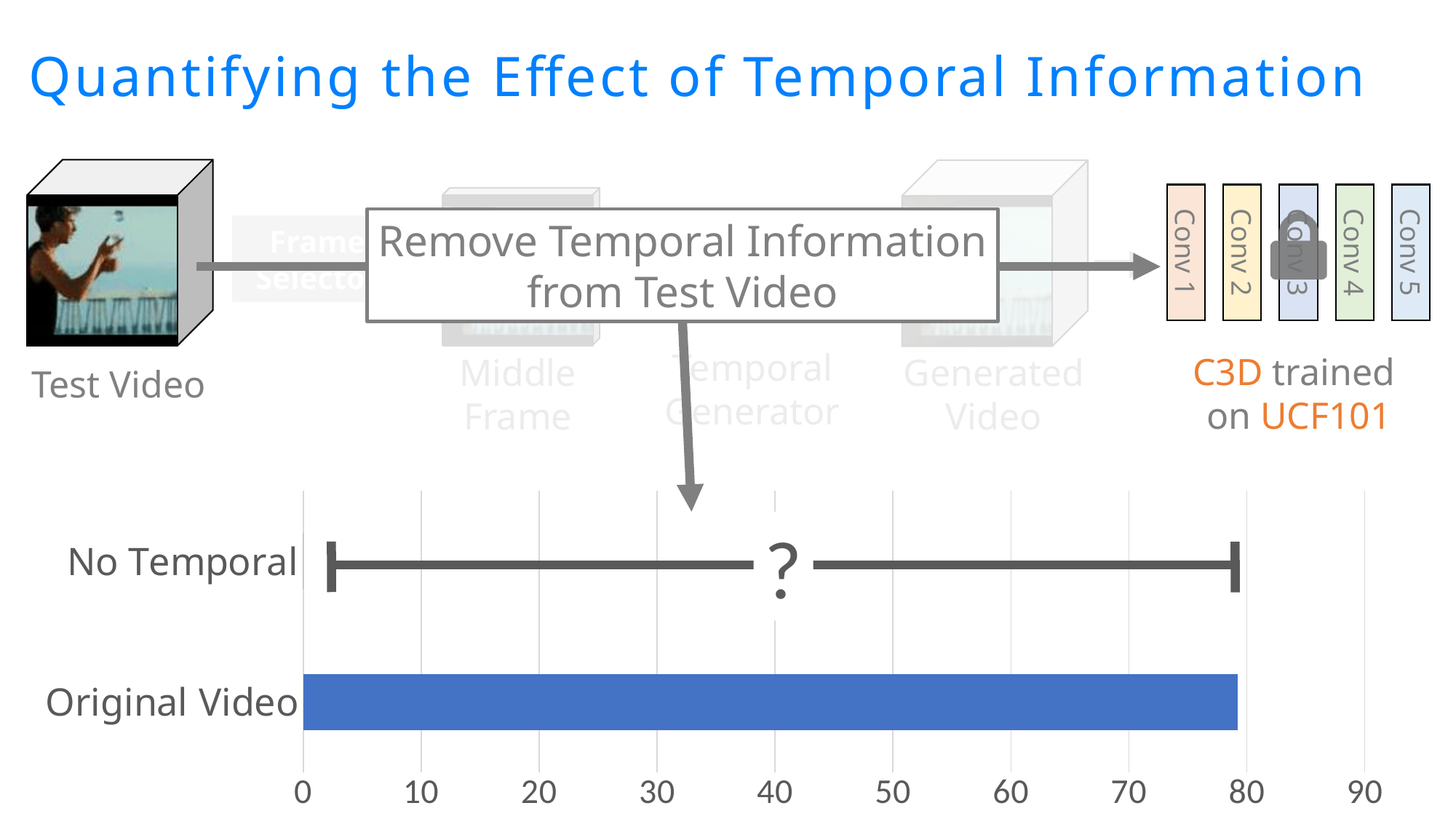
Is the value for Original Video greater or less than 50? greater Which category in the bar chart is shown with a question mark instead of a filled bar? No Temporal How many categories are listed on the vertical axis of the bar chart? 2 What is the highest tick value shown on the horizontal axis of the bar chart? 90 Is the value for Original Video greater or less than 90? less Is the value for Original Video greater or less than 70? greater What kind of chart is shown at the bottom of the slide? bar chart